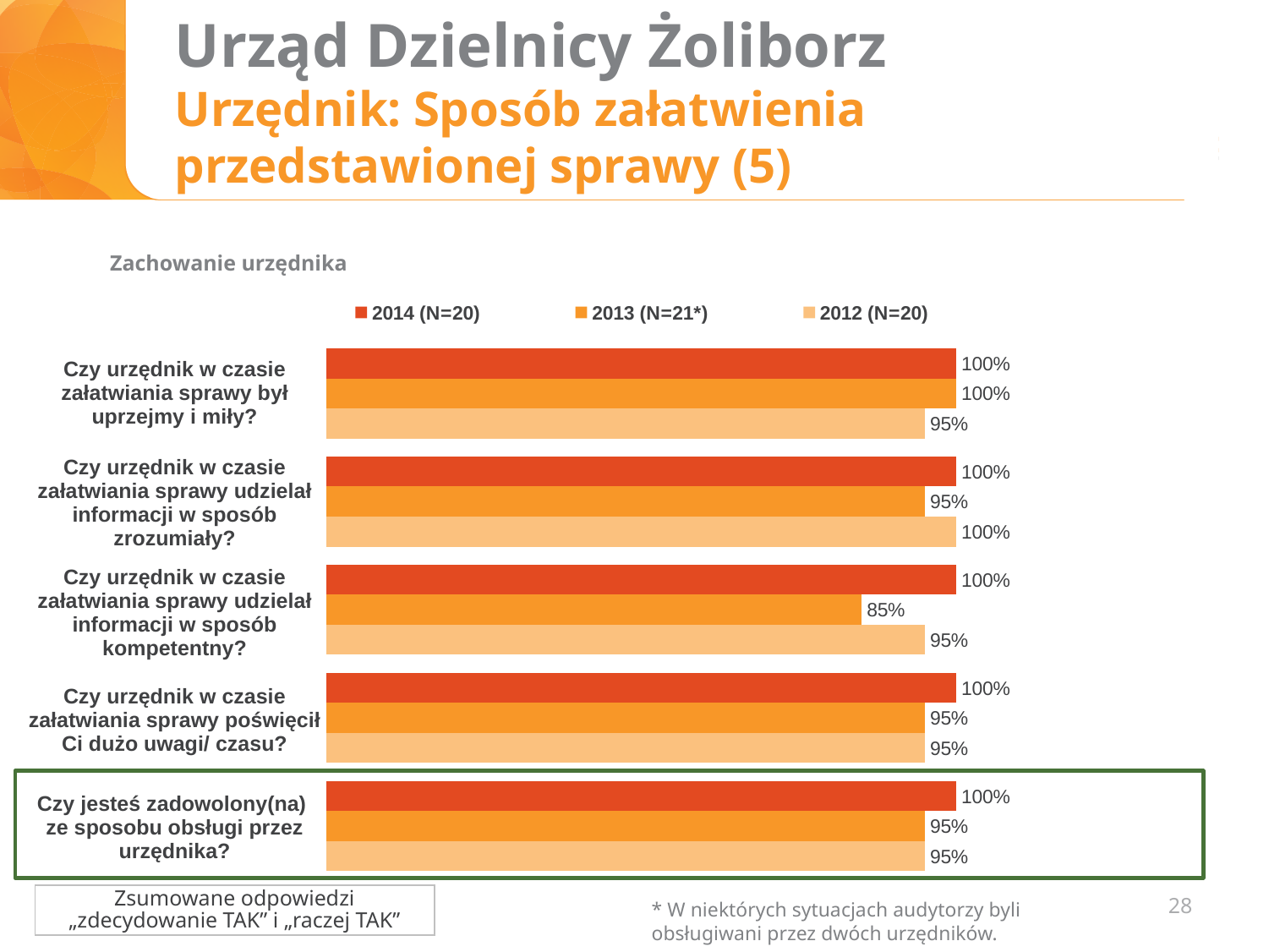
What is the 2013 (N=21*) value for "Czy urzędnik w czasie załatwiania sprawy udzielał informacji w sposób kompetentny?" 85% What is the difference between the 2014 (N=20) and 2013 (N=21*) values for "Czy urzędnik w czasie załatwiania sprawy udzielał informacji w sposób kompetentny?" 15% What type of chart is shown on the slide? bar chart What is the difference between the 2014 (N=20) and 2012 (N=20) values for "Czy urzędnik w czasie załatwiania sprawy poświęcił Ci dużo uwagi/ czasu?" 5% Which series has the lowest value for "Czy urzędnik w czasie załatwiania sprawy udzielał informacji w sposób kompetentny?" 2013 (N=21*) What is the 2012 (N=20) value for "Czy urzędnik w czasie załatwiania sprawy był uprzejmy i miły?" 95% How many question categories are plotted in the chart? 5 What is the title shown above the chart? Zachowanie urzędnika What is the 2012 (N=20) value for "Czy urzędnik w czasie załatwiania sprawy udzielał informacji w sposób zrozumiały?" 100% What is the 2014 (N=20) value for "Czy jesteś zadowolony(na) ze sposobu obsługi przez urzędnika?" 100% For "Czy urzędnik w czasie załatwiania sprawy udzielał informacji w sposób zrozumiały?", which is larger: the 2013 (N=21*) value or the 2012 (N=20) value? 2012 (N=20) How many series does the chart legend list? 3